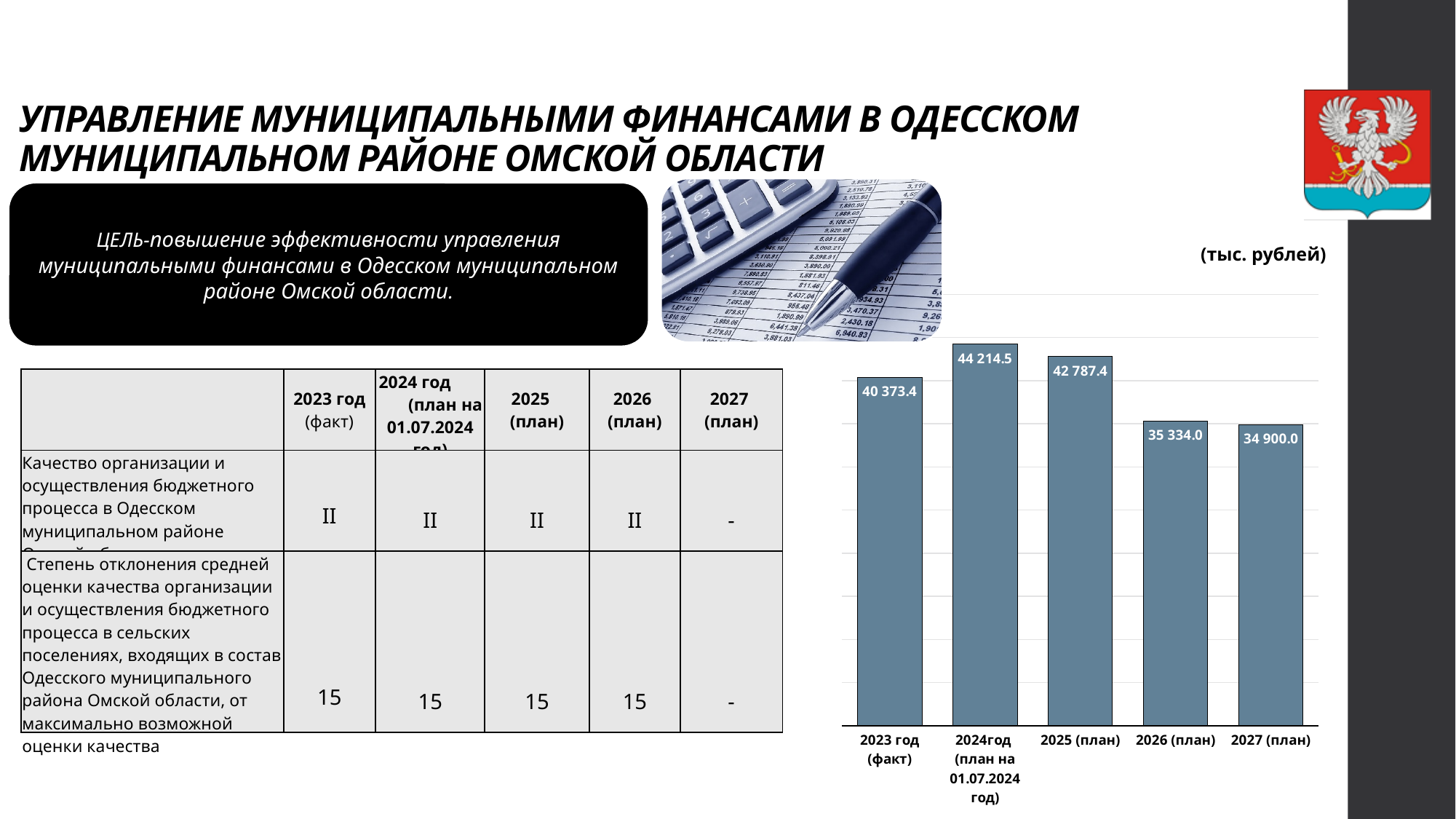
What is the value shown for 2027 (план) on the bar chart? 34 900.0 What is the difference between the values for 2026 (план) and 2027 (план)? 434.0 What is the value shown for 2025 (план) on the bar chart? 42 787.4 What is the difference between the values for 2024год (план на 01.07.2024 год) and 2023 год (факт)? 3 841.1 What is the value shown for 2023 год (факт) on the bar chart? 40 373.4 Which category has the lowest value on the bar chart? 2027 (план) Do the values on the bar chart rise or fall from 2025 (план) to 2027 (план)? Fall In what units are the values on the bar chart expressed, according to the label above the chart? тыс. рублей What kind of chart is shown on the right side of the slide? Bar chart Which category has the highest value on the bar chart? 2024год (план на 01.07.2024 год) How many bars are plotted on the bar chart? 5 Which is larger on the bar chart: the value for 2025 (план) or the value for 2026 (план)? 2025 (план)